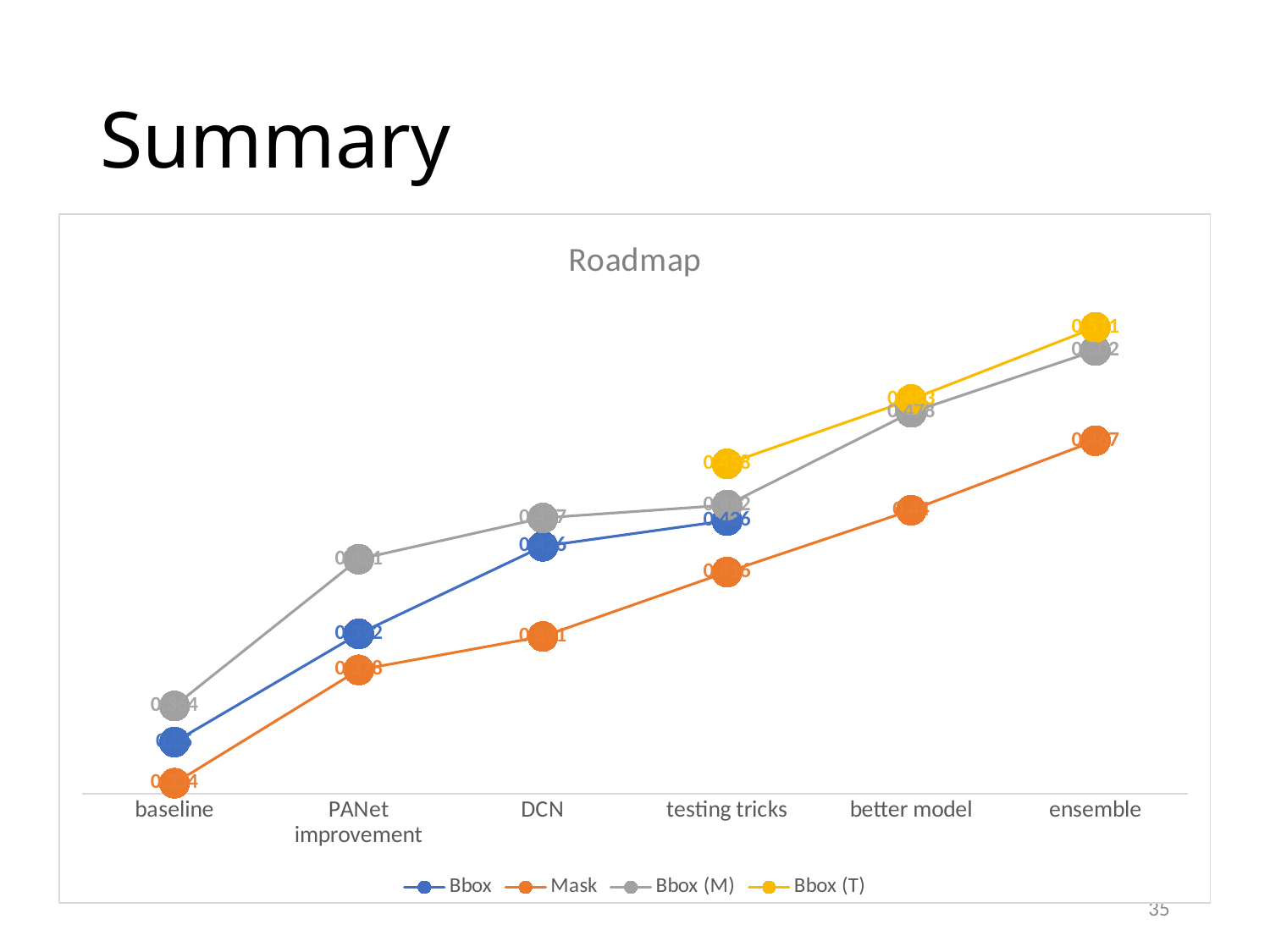
At testing tricks, which is higher, Bbox (T) or Mask? Bbox (T) What kind of chart is shown on the slide? line chart Which series is drawn in orange? Mask At which category is the Bbox (M) series lowest? baseline At baseline, which series has the lower value, Bbox (M) or Mask? Mask How many categories are shown on the x axis? 6 Does the Mask series rise or fall from baseline to ensemble? rise At which category does the Mask series reach its highest value? ensemble How many data points does the Bbox (T) series have? 3 Does the Bbox (M) series rise or fall along the x axis? rise What is the title of the chart? Roadmap How many series does the legend list? 4